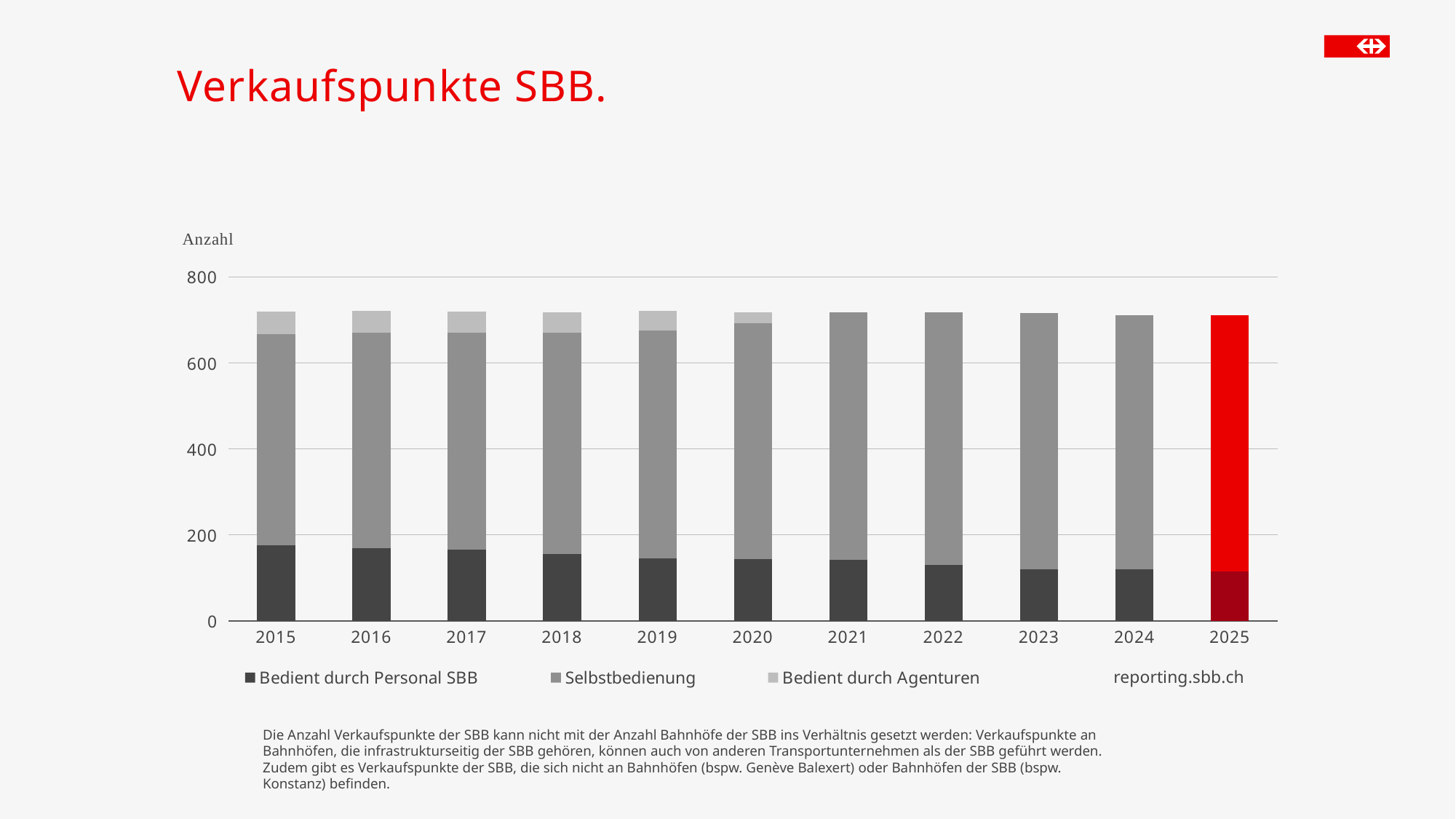
Does the Bedient durch Personal SBB segment rise or fall from 2015 to 2025? fall Is the value for Bedient durch Personal SBB in 2025 greater or less than 200? less Is the total height of the stacked bar for 2025 greater or less than 800? less How many years are shown on the x axis of the chart? 11 Is the total height of the stacked bar for 2015 greater or less than 600? greater What is the title of the chart on the slide? Verkaufspunkte SBB. What label is shown on the y axis of the chart? Anzahl What kind of chart is shown on the slide? stacked bar chart How many series does the chart legend list? 3